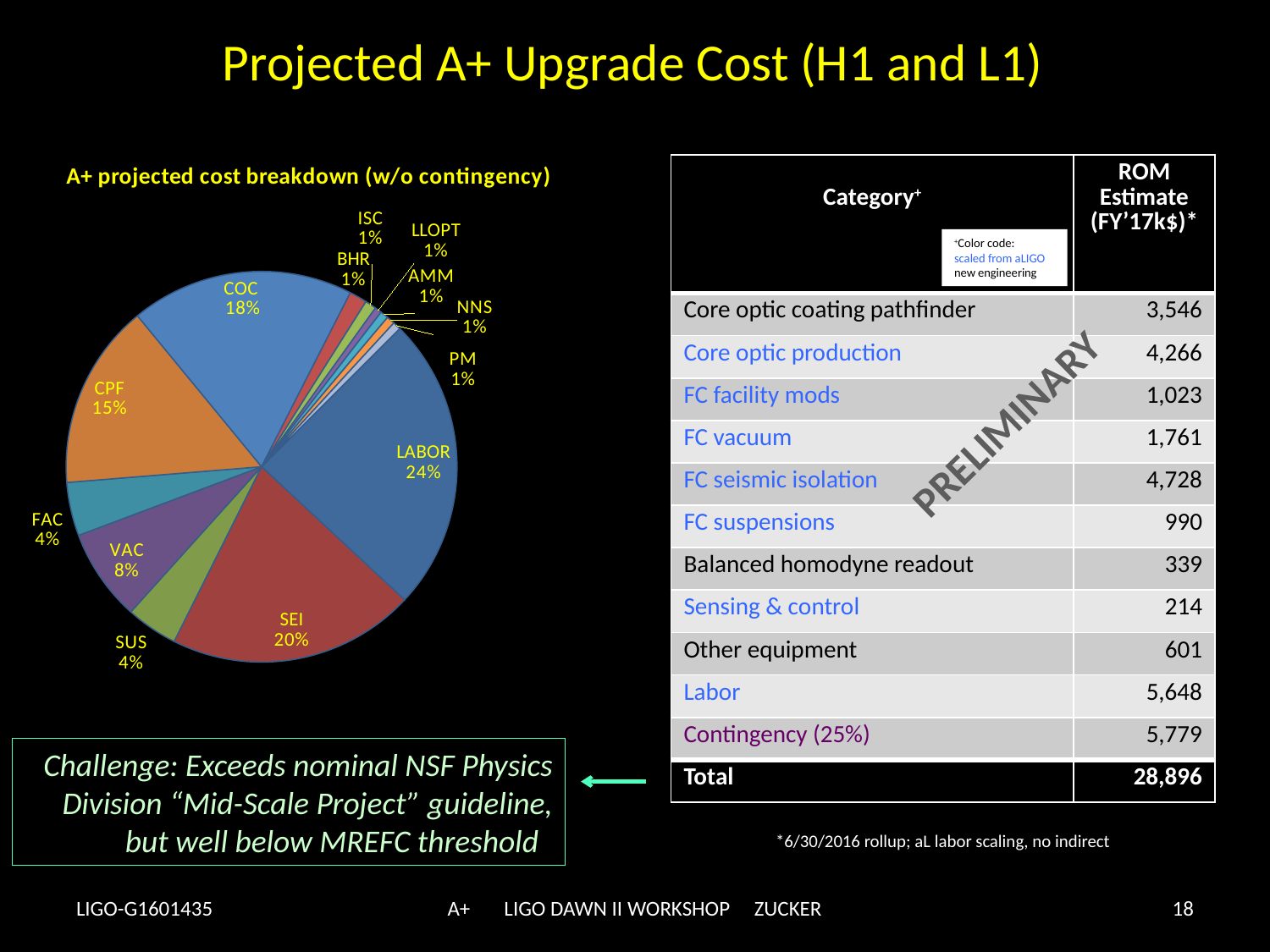
What share of the pie does LABOR represent? 24% What percentage is shown for VAC in the pie chart? 8% What percentage is shown for CPF in the pie chart? 15% What kind of chart is shown on the slide? pie chart How many slices does the pie chart have? 13 What is the title of the pie chart? A+ projected cost breakdown (w/o contingency) What is the difference in percentage points between LABOR and SEI? 4 What share of the pie does SEI represent? 20% Which is larger, the COC slice or the CPF slice? COC Which category has the largest slice of the pie? LABOR What percentage is shown for COC in the pie chart? 18% What is the difference in percentage points between VAC and FAC? 4